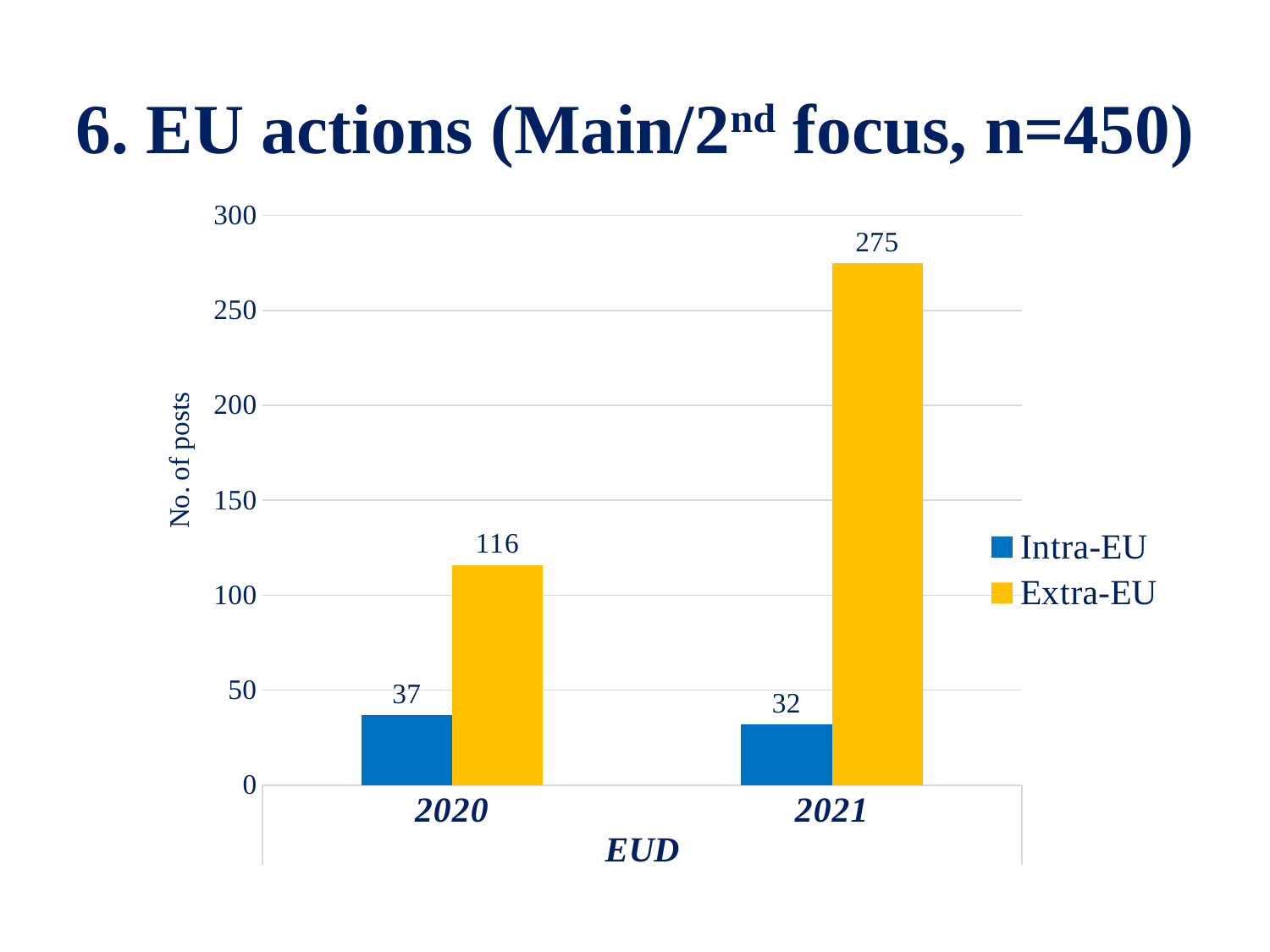
Which is larger in 2020, Intra-EU or Extra-EU? Extra-EU How many series does the legend list? 2 What is the Intra-EU value for 2021? 32 What is the Intra-EU value for 2020? 37 What is the label of the vertical axis? No. of posts Does the Extra-EU value rise or fall from 2020 to 2021? Rise Which year has the lowest Intra-EU value? 2021 What kind of chart is shown on the slide? Bar chart Which year has the highest Extra-EU value? 2021 What is the Extra-EU value for 2021? 275 What is the difference between the Extra-EU values for 2021 and 2020? 159 What is the Extra-EU value for 2020? 116